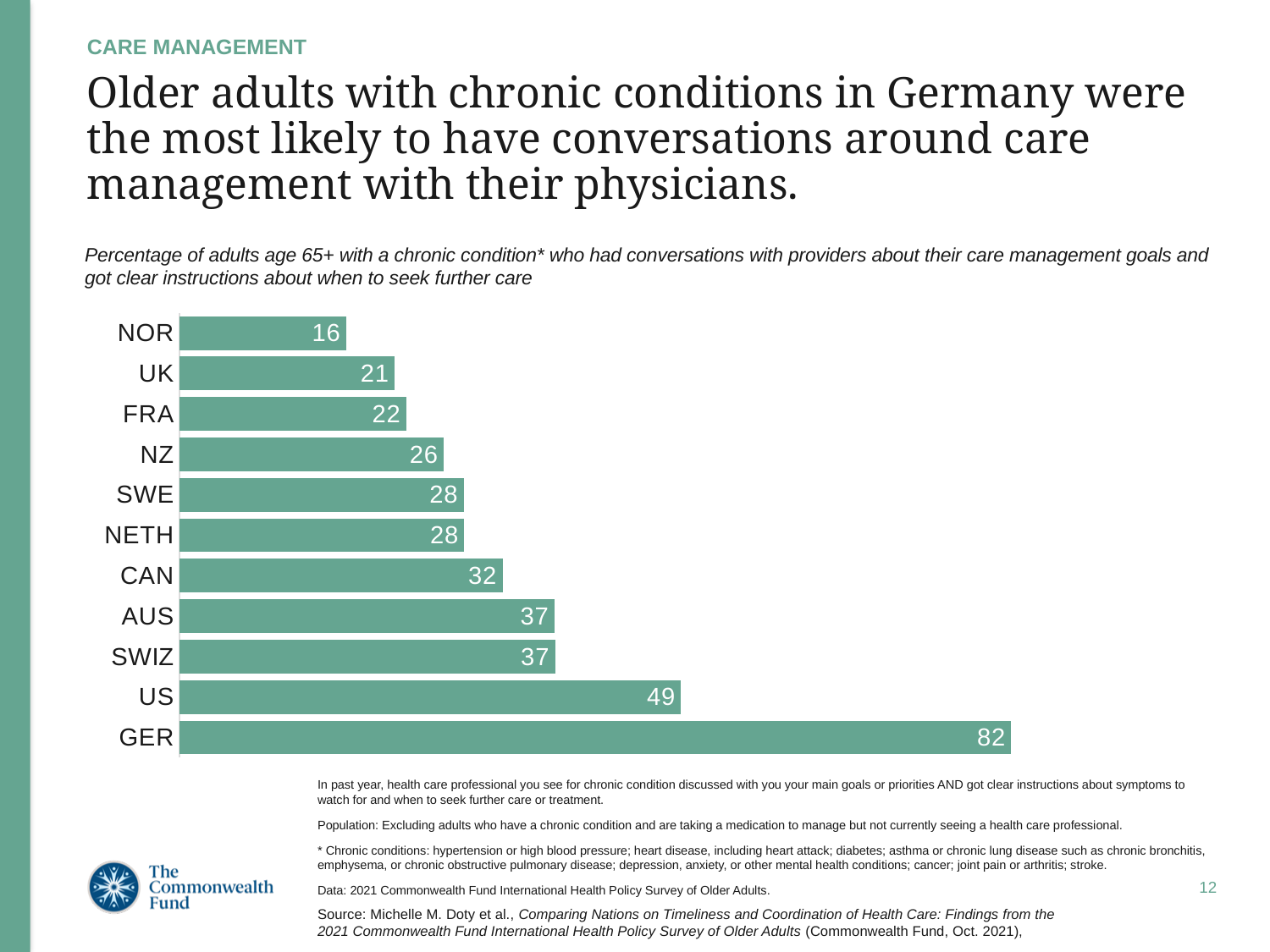
Which country has the lowest value? NOR What is the difference between the values for GER and US? 33 What is the value for NETH? 28 What colour are the bars in the chart? Green What is the value for GER? 82 What kind of chart is shown on the slide? Bar chart What is the value for US? 49 How many countries are shown in the chart? 11 What is the difference between the values for CAN and UK? 11 Which two countries both have a value of 37? AUS and SWIZ Which is larger, the value for AUS or the value for NZ? AUS Which country has the highest value? GER